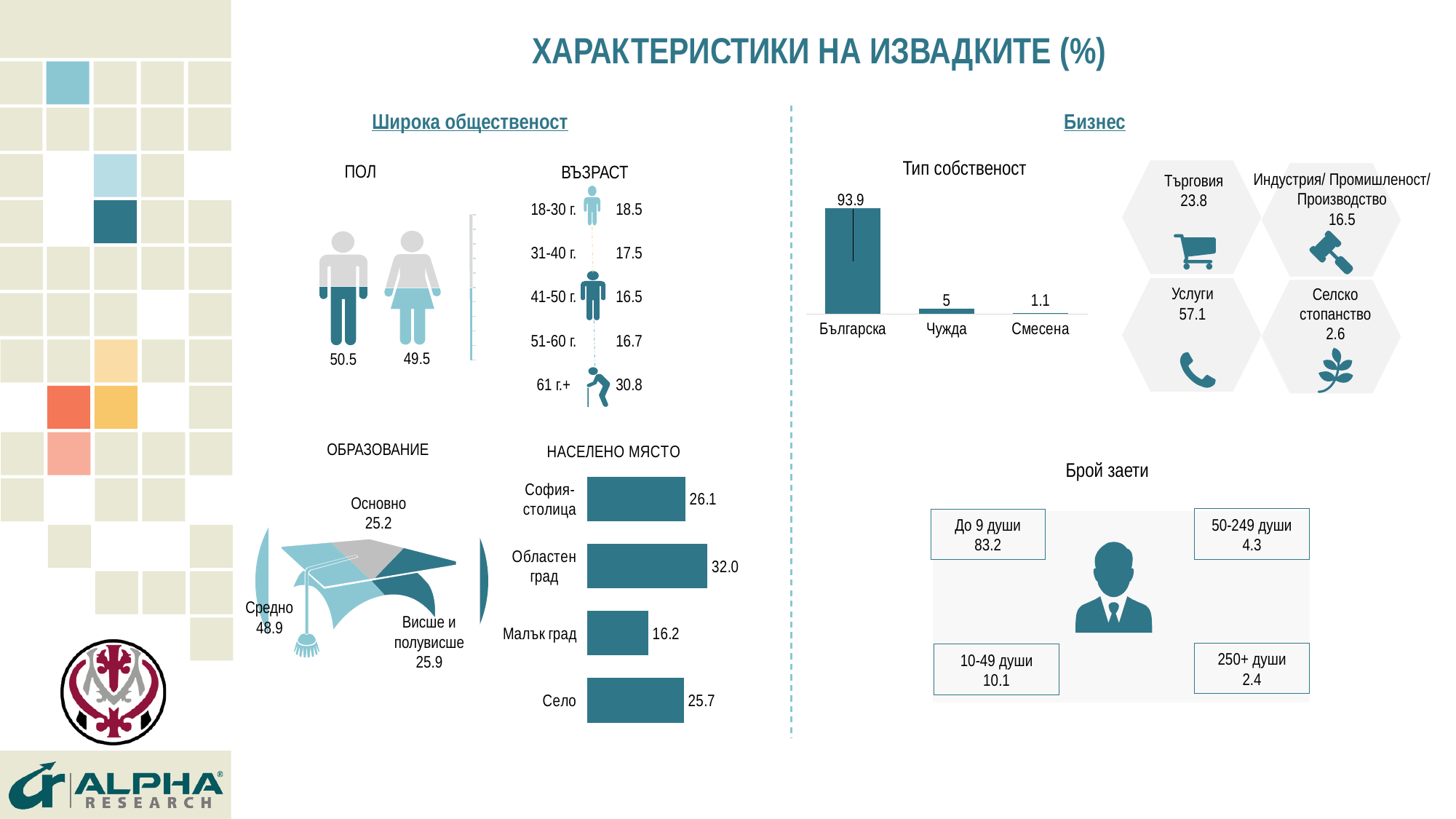
In the "НАСЕЛЕНО МЯСТО" chart, which is larger: София-столица or Село? София-столица In the "Тип собственост" chart, which category has the lowest value? Смесена In the "НАСЕЛЕНО МЯСТО" chart, what is the value for Областен град? 32.0 How many categories are shown in the "НАСЕЛЕНО МЯСТО" chart? 4 In the "Тип собственост" chart, what is the difference between Българска and Чужда? 88.9 In the "НАСЕЛЕНО МЯСТО" chart, which category has the lowest value? Малък град In the "НАСЕЛЕНО МЯСТО" chart, what is the difference between Областен град and Малък град? 15.8 How many categories are shown in the "Тип собственост" chart? 3 In the "Тип собственост" chart, what is the value for Чужда? 5 In the "НАСЕЛЕНО МЯСТО" chart, which category has the highest value? Областен град In the "Тип собственост" chart, what is the value for Българска? 93.9 What kind of chart is the "Тип собственост" chart? bar chart